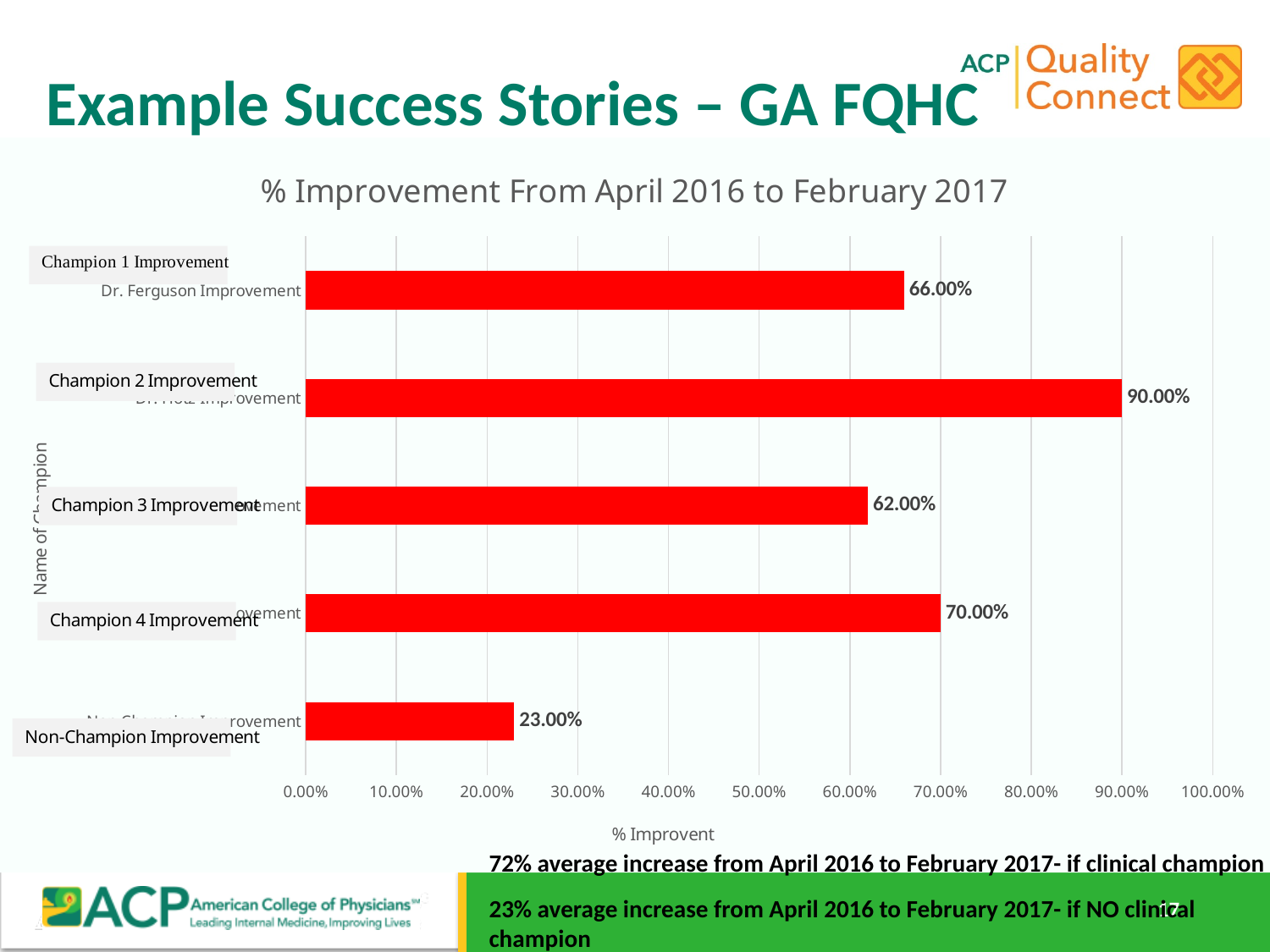
How many categories are shown in the chart? 5 What is the difference between Champion 2 Improvement and Non-Champion Improvement? 67.00% Which category has the highest value? Champion 2 Improvement What is the value for Champion 4 Improvement? 70.00% Which category has the lowest value? Non-Champion Improvement What is the value for Champion 2 Improvement? 90.00% What is the label of the x axis? % Improvent What is the value for Non-Champion Improvement? 23.00% What kind of chart is shown on the slide? Bar chart What is the value for Champion 3 Improvement? 62.00% What is the title of the chart? % Improvement From April 2016 to February 2017 Which is larger, Champion 1 Improvement or Champion 4 Improvement? Champion 4 Improvement